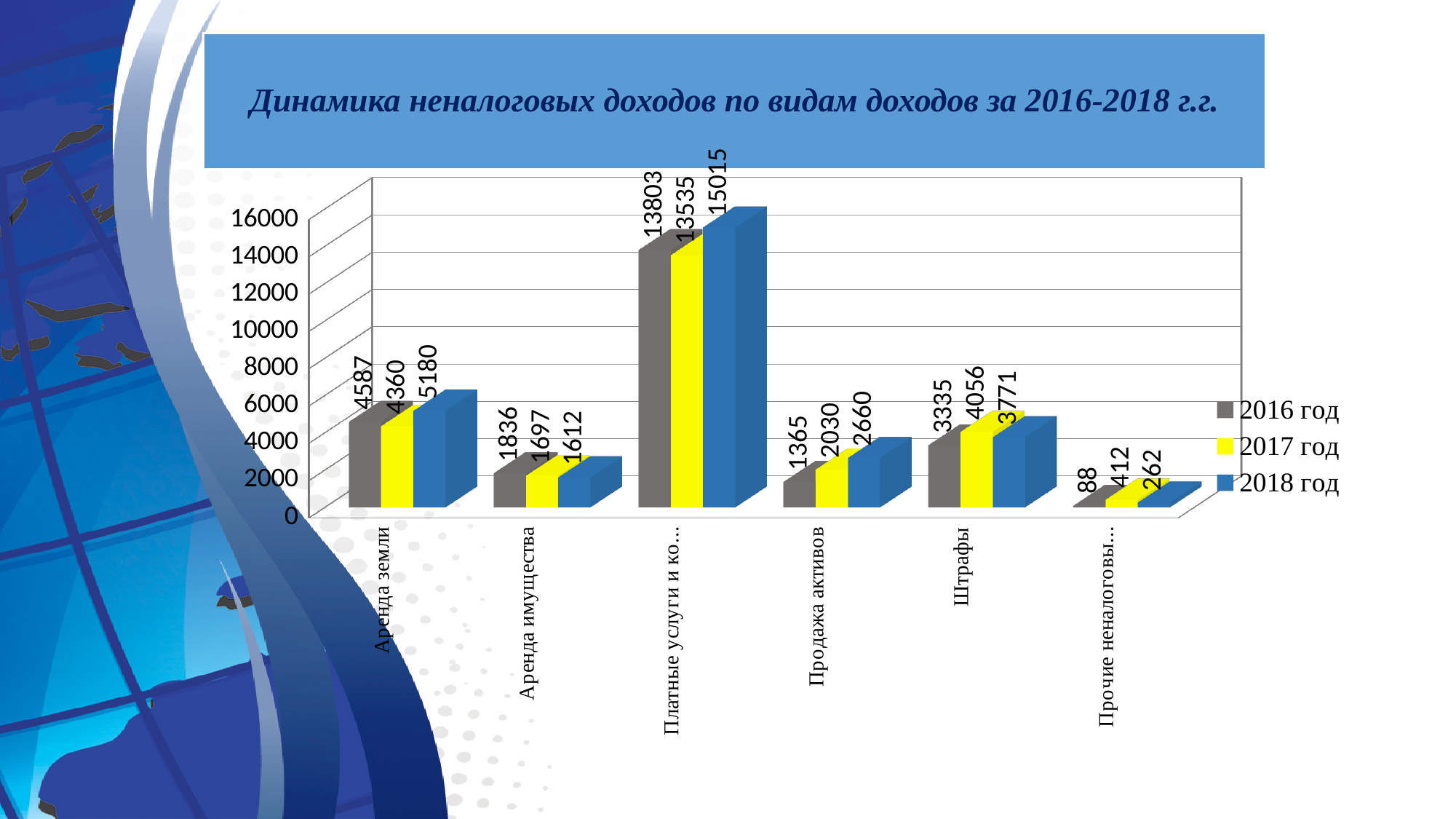
What is the value for Штрафы in the 2017 год series? 4056 Is the 2018 год value for Аренда земли greater or less than 4000? greater How many series does the legend list? 3 What kind of chart is shown on the slide? bar chart Do the values for Аренда имущества rise or fall from 2016 год to 2018 год? fall How many categories are shown on the x axis? 6 Which category has the lowest value in the 2016 год series? Прочие неналоговы... What is the value for Продажа активов in the 2016 год series? 1365 What is the value for Аренда земли in the 2018 год series? 5180 Which category has the highest value in the 2018 год series? Платные услуги и ко... What is the difference between the 2018 год and 2016 год values for Продажа активов? 1295 Which is larger for Штрафы: the 2017 год value or the 2018 год value? 2017 год